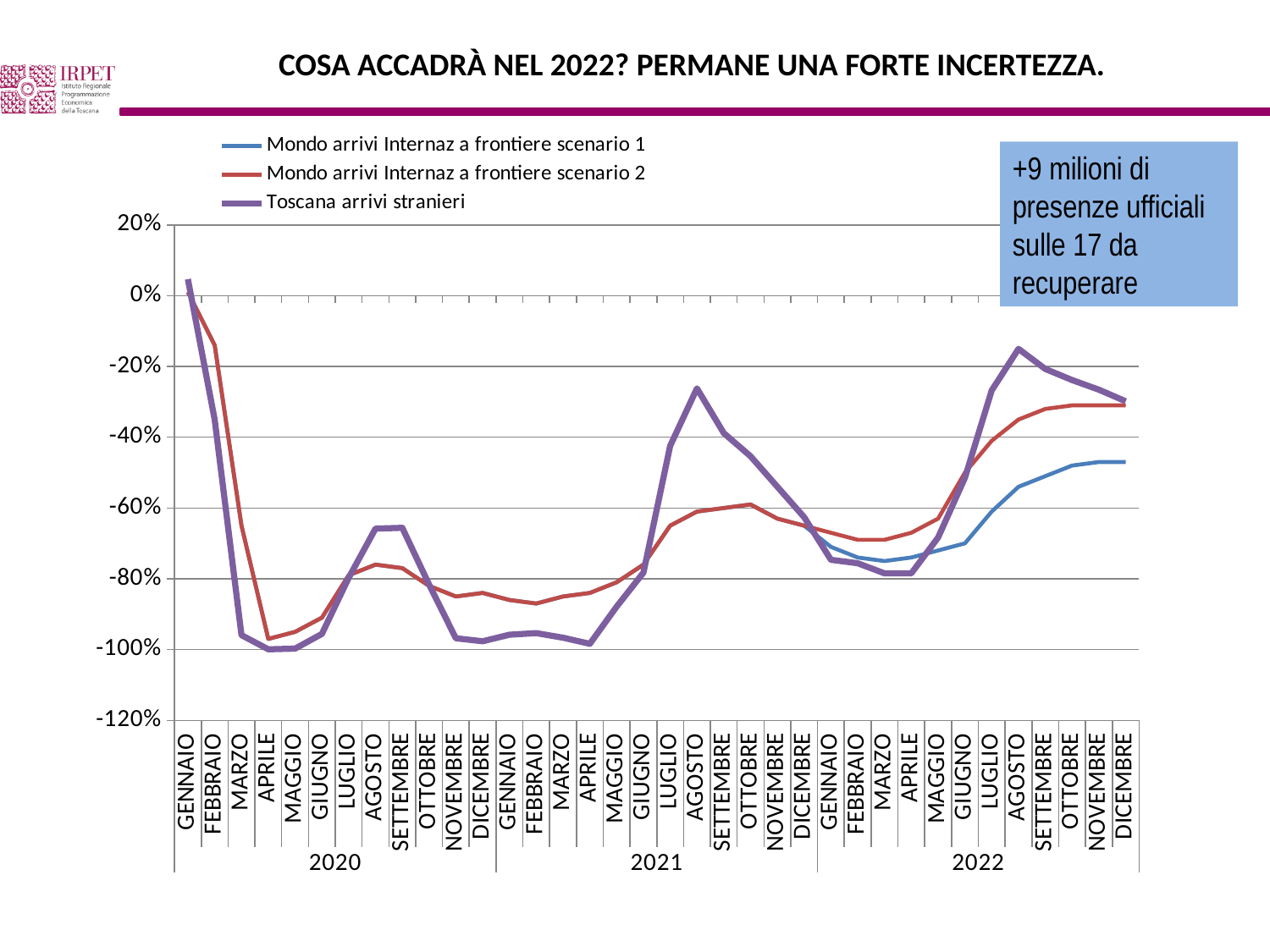
How many years are shown along the x axis? 3 In DICEMBRE 2022, which is higher: Mondo arrivi Internaz a frontiere scenario 1 or scenario 2? scenario 2 Which series is drawn in purple? Toscana arrivi stranieri Does the Mondo arrivi Internaz a frontiere scenario 1 series rise or fall from GIUGNO 2022 to DICEMBRE 2022? rise Is the value for Mondo arrivi Internaz a frontiere scenario 1 in DICEMBRE 2022 greater or less than -40%? less In which month is the Toscana arrivi stranieri series at its highest? GENNAIO 2020 How many series does the legend list? 3 Is the value for Toscana arrivi stranieri in AGOSTO 2022 greater or less than -20%? greater What is the title of the slide containing the chart? COSA ACCADRÀ NEL 2022? PERMANE UNA FORTE INCERTEZZA. Is the value for Mondo arrivi Internaz a frontiere scenario 2 in FEBBRAIO 2021 greater or less than -80%? less What kind of chart is shown on the slide? line chart